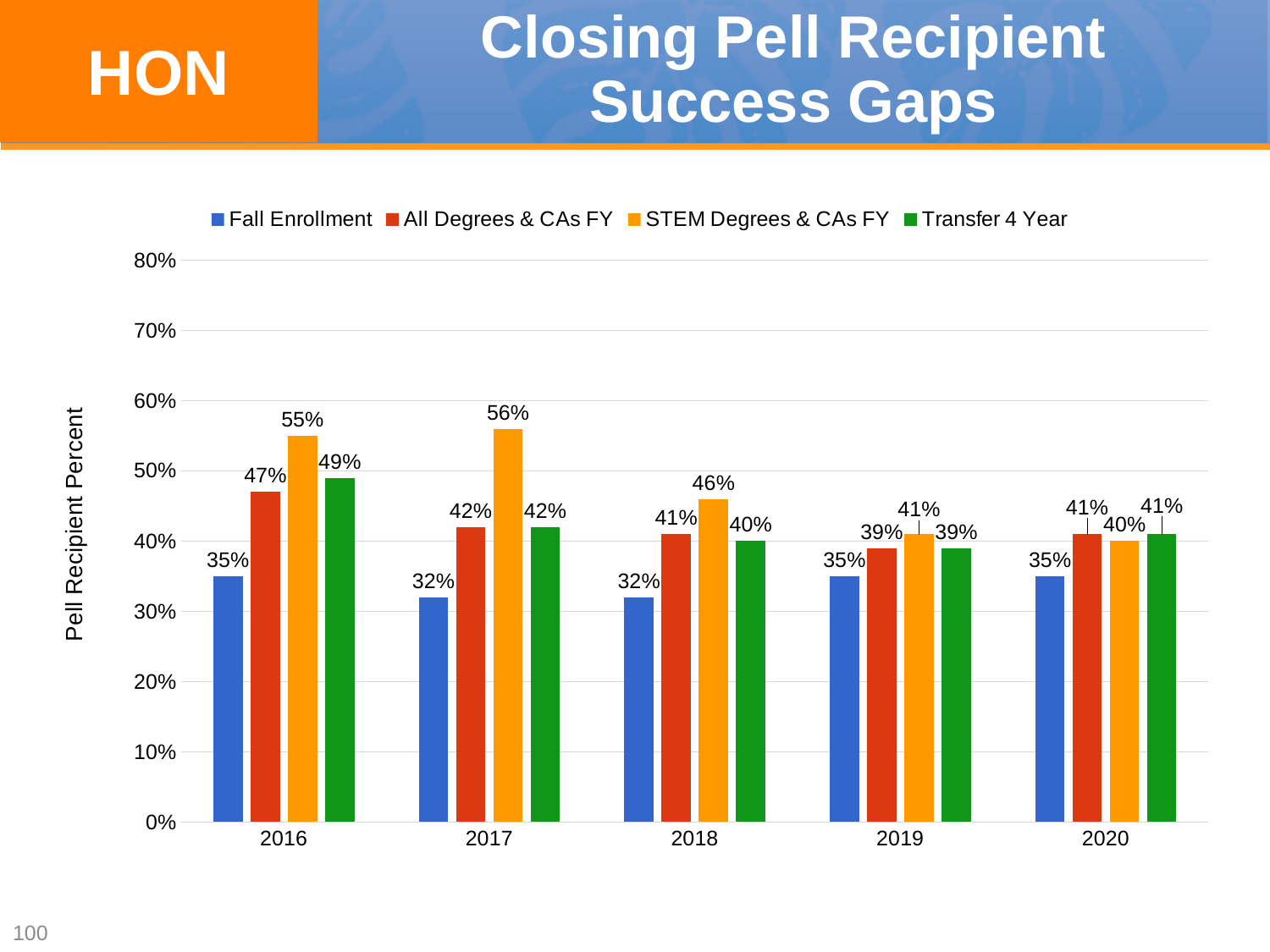
How many series does the legend list? 4 What is the Transfer 4 Year value for 2016? 49% What is the Fall Enrollment value for 2019? 35% How many years are shown on the x axis? 5 In which year is the Fall Enrollment value lowest? 2017 and 2018 What is the difference between the STEM Degrees & CAs FY value and the Fall Enrollment value in 2016? 20% What is the STEM Degrees & CAs FY value for 2017? 56% Which is larger in 2018: All Degrees & CAs FY or Transfer 4 Year? All Degrees & CAs FY Is the Transfer 4 Year value for 2016 greater or less than 40%? greater What is the label on the vertical axis? Pell Recipient Percent What kind of chart is shown on the slide? bar chart In which year is the STEM Degrees & CAs FY value highest? 2017